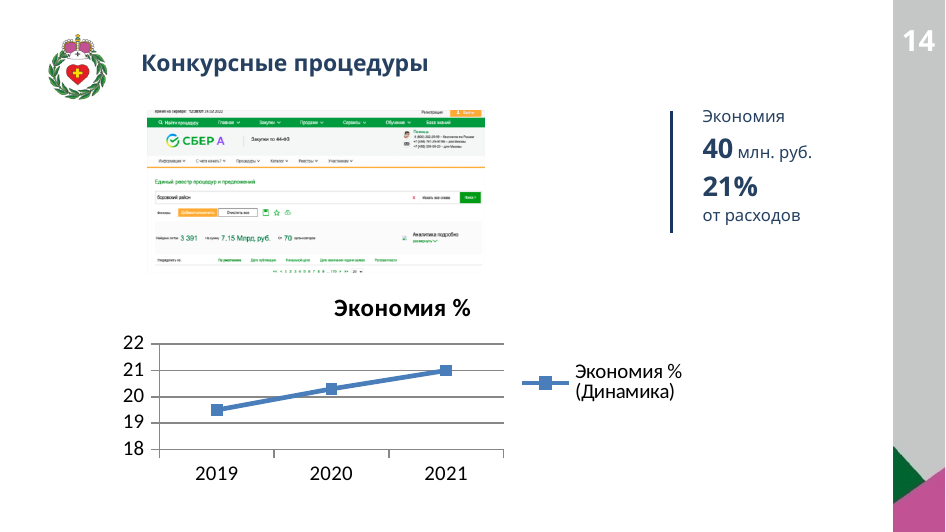
How many series does the chart legend list? 1 Is the value for 2019 greater or less than 19? greater What kind of chart is shown on the slide? line chart Is the value for 2019 greater or less than 20? less Is the value for 2021 greater or less than 20? greater What is the legend entry for the series in the chart? Экономия % (Динамика) Which year has the larger value, 2019 or 2021? 2021 How many years are plotted on the x axis of the chart? 3 Which year has the lowest value in the chart? 2019 Do the values in the chart rise or fall from 2019 to 2021? rise What is the title of the chart? Экономия % Which year has the highest value in the chart? 2021